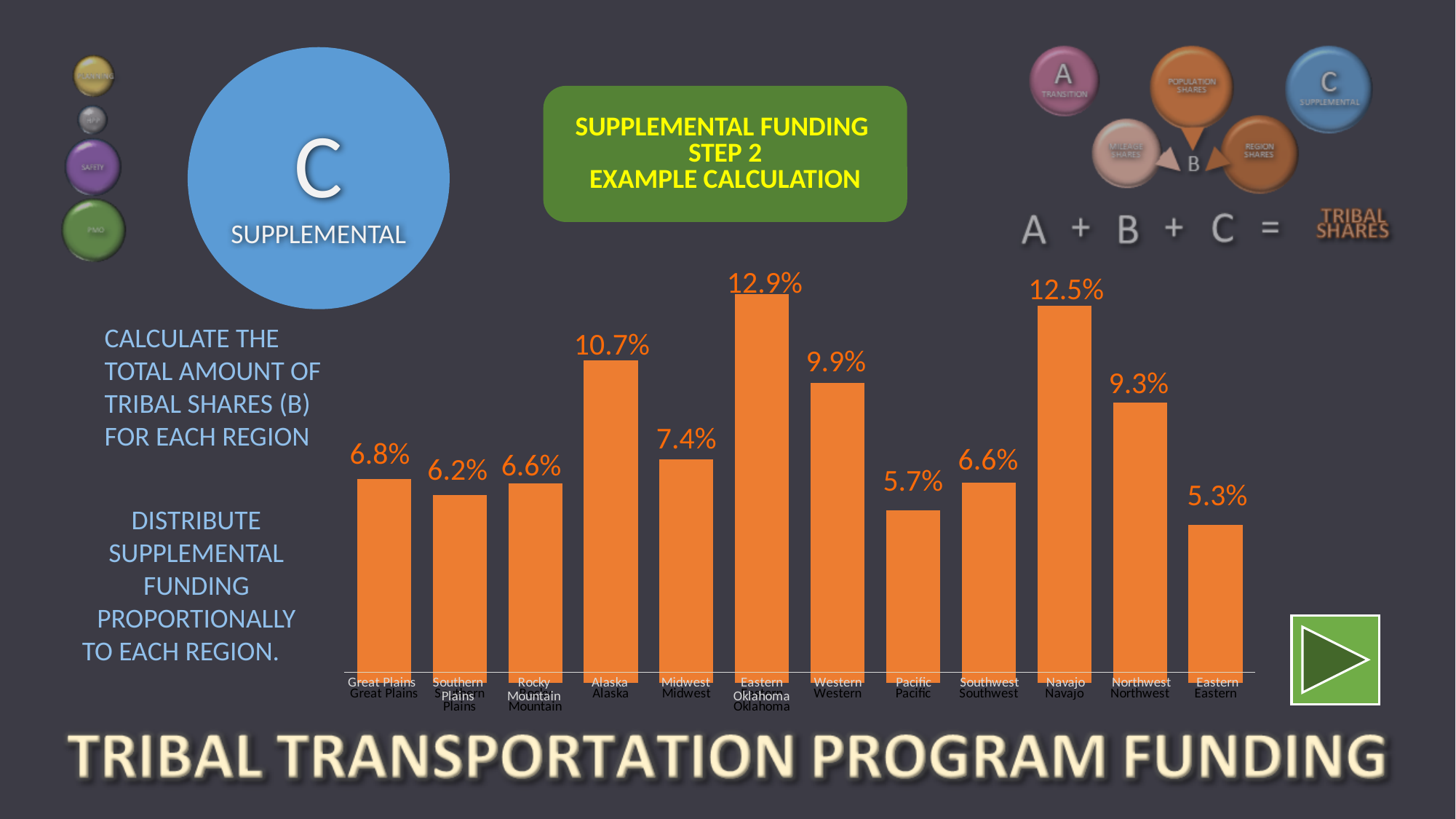
Which region has the highest value? Eastern Oklahoma Which is larger, the value for Alaska or the value for Western? Alaska What is the difference between the values for Alaska and Great Plains? 3.9% What is the value for Pacific? 5.7% What colour are the bars in the chart? orange What is the value for Midwest? 7.4% Which region has the lowest value? Eastern What is the value for Navajo? 12.5% How many regions are shown in the chart? 12 What kind of chart is shown on the slide? bar chart What is the difference between the values for Eastern Oklahoma and Navajo? 0.4% What is the value for Eastern Oklahoma? 12.9%